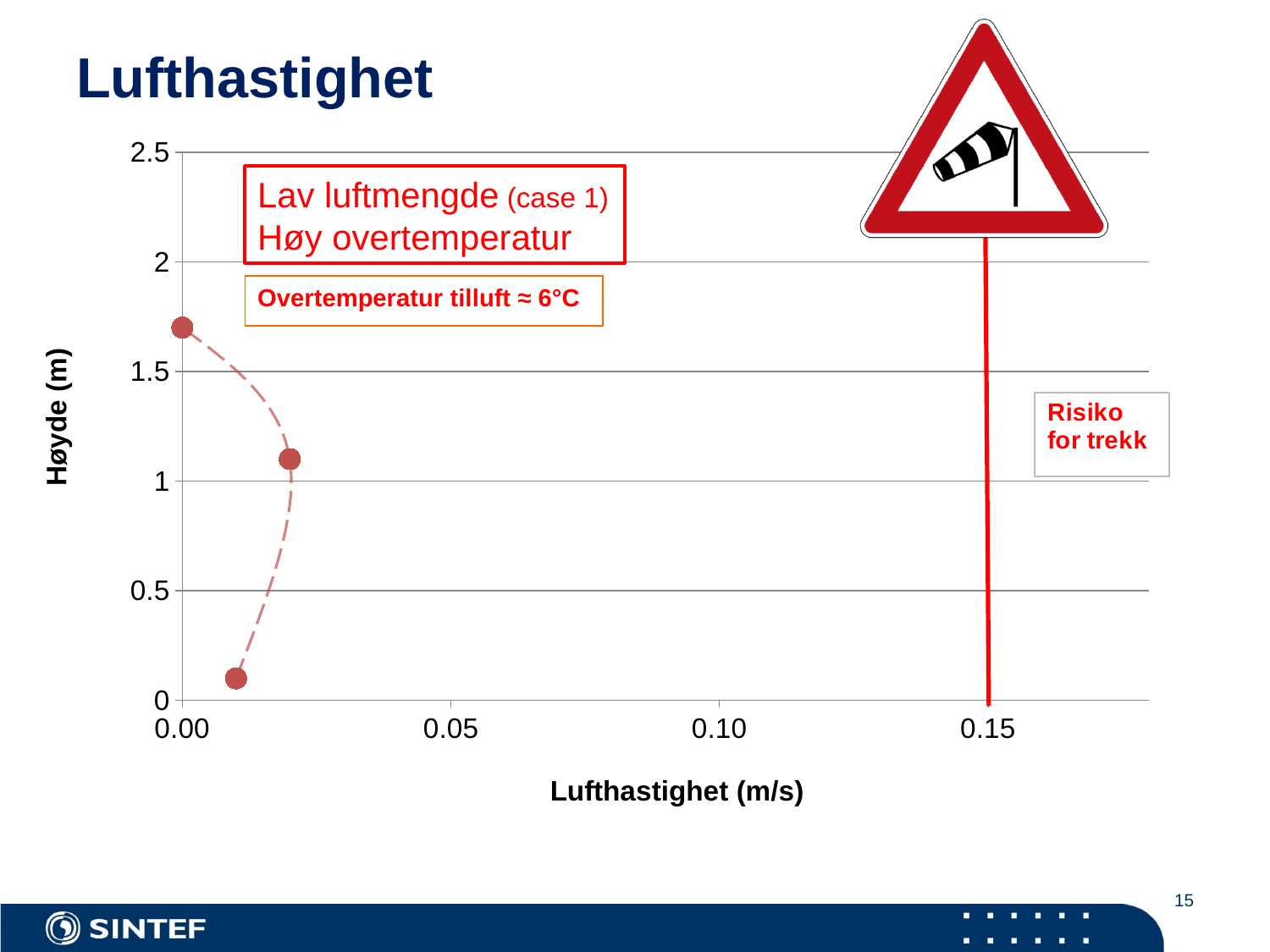
Is the height of the lowest plotted point greater or less than 0.5 m? less At what air velocity (x value) is the vertical red line labelled 'Risiko for trekk' drawn? 0.15 Which plotted point has the lowest air velocity: the top, middle or bottom point? the top point What kind of chart is shown on the slide? Scatter chart with a dashed line Is the air velocity of the highest plotted point (at about 1.7 m height) greater or less than 0.05 m/s? less Are all plotted air velocities greater or less than the 0.15 m/s 'Risiko for trekk' line? less What is the title of the chart's x axis? Lufthastighet (m/s) Which plotted point has the highest air velocity: the top, middle or bottom point? the middle point How many data points are plotted on the chart? 3 What is the title of the chart's y axis? Høyde (m)